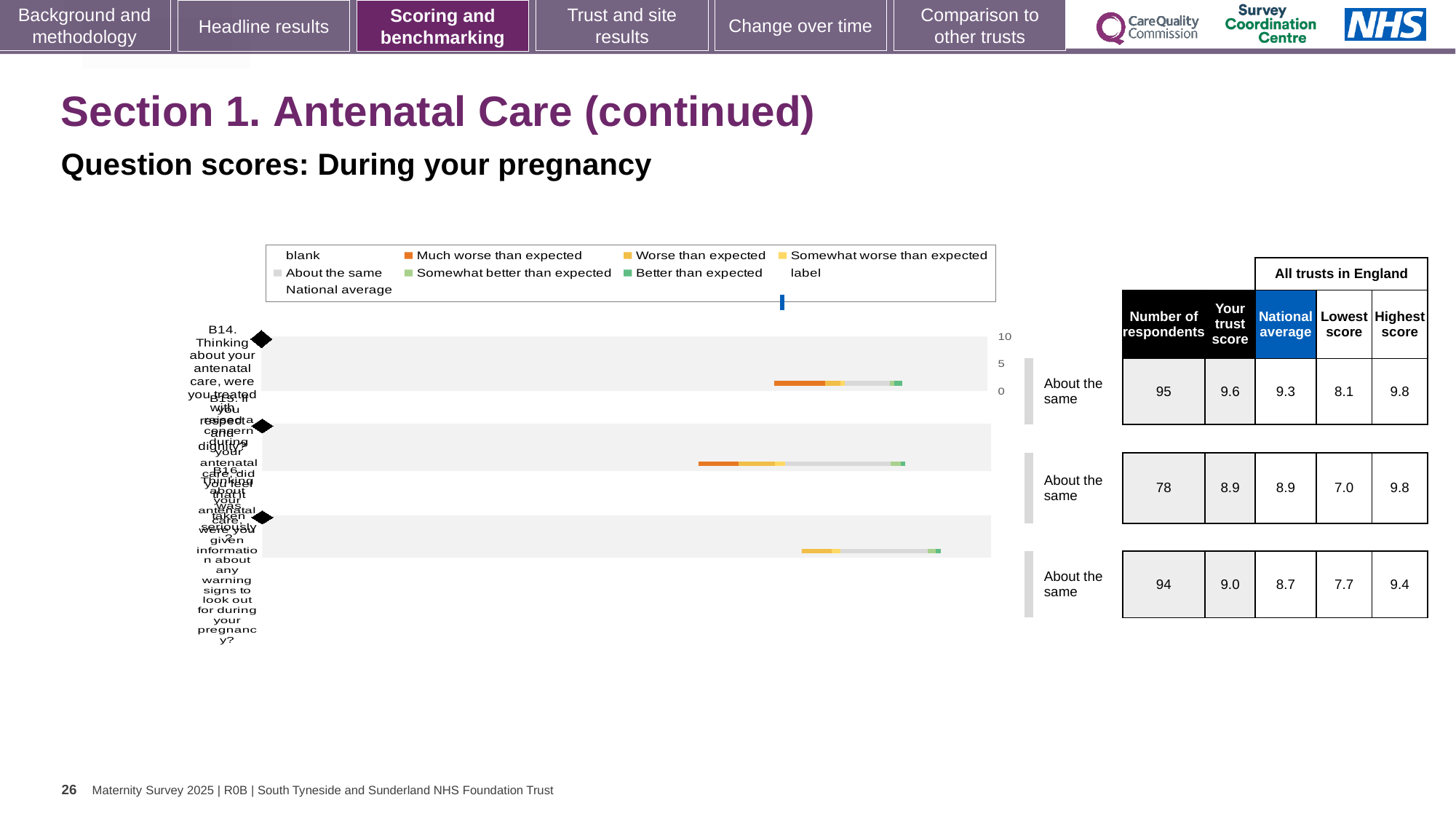
What is the national average for the second question row? 8.9 What is the trust score for the first question row (B14, treated with respect and dignity)? 9.6 What is the number of respondents for the first question row (B14, treated with respect and dignity)? 95 Which question row has the lowest number of respondents? the second row How many question rows (bars) are plotted in the chart? 3 What is the difference between the trust score and the national average for the third question row? 0.3 What is the highest score among all trusts in England for the third question row? 9.4 What is the lowest score among all trusts in England for the second question row? 7.0 What colour does the legend use for 'Much worse than expected'? orange What kind of chart is shown on the slide? bar chart Which question row has the highest trust score? the first row (B14, treated with respect and dignity) Is the trust score for the first question row larger than its national average? yes